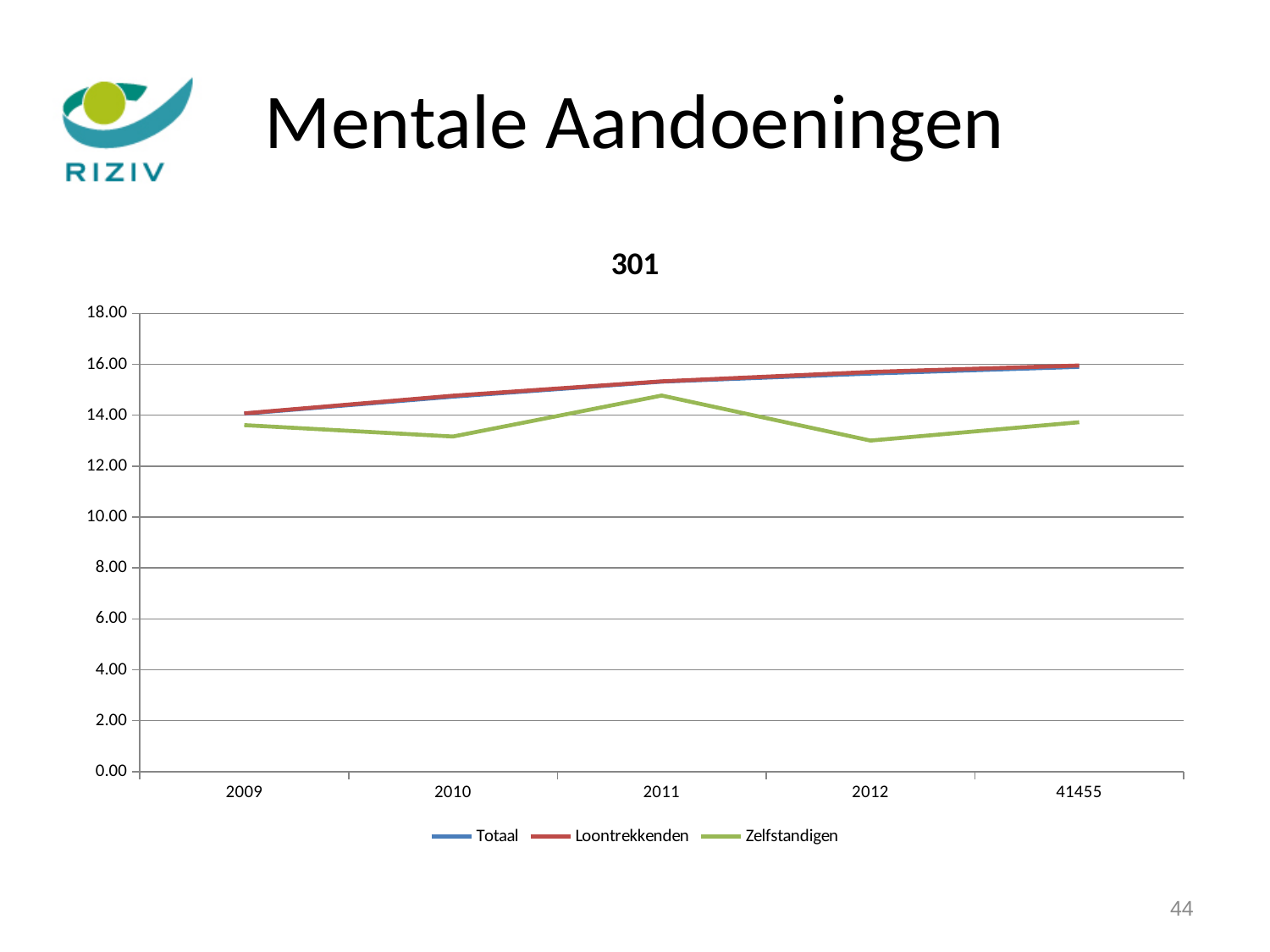
Does the Loontrekkenden line rise or fall from 2009 to the last point? rise In which year does the Zelfstandigen line reach its highest value? 2011 Is the value for Zelfstandigen in 2012 greater or less than 14.00? less How many series does the legend list? 3 How many points are plotted along the x axis? 5 What kind of chart is shown on the slide? line chart Is the value for Totaal in 2009 greater or less than 12.00? greater Which series is drawn in green in the legend? Zelfstandigen Is the value for Loontrekkenden in 2011 greater or less than 14.00? greater In 2012, which is larger: Loontrekkenden or Zelfstandigen? Loontrekkenden What is the title of the chart? 301